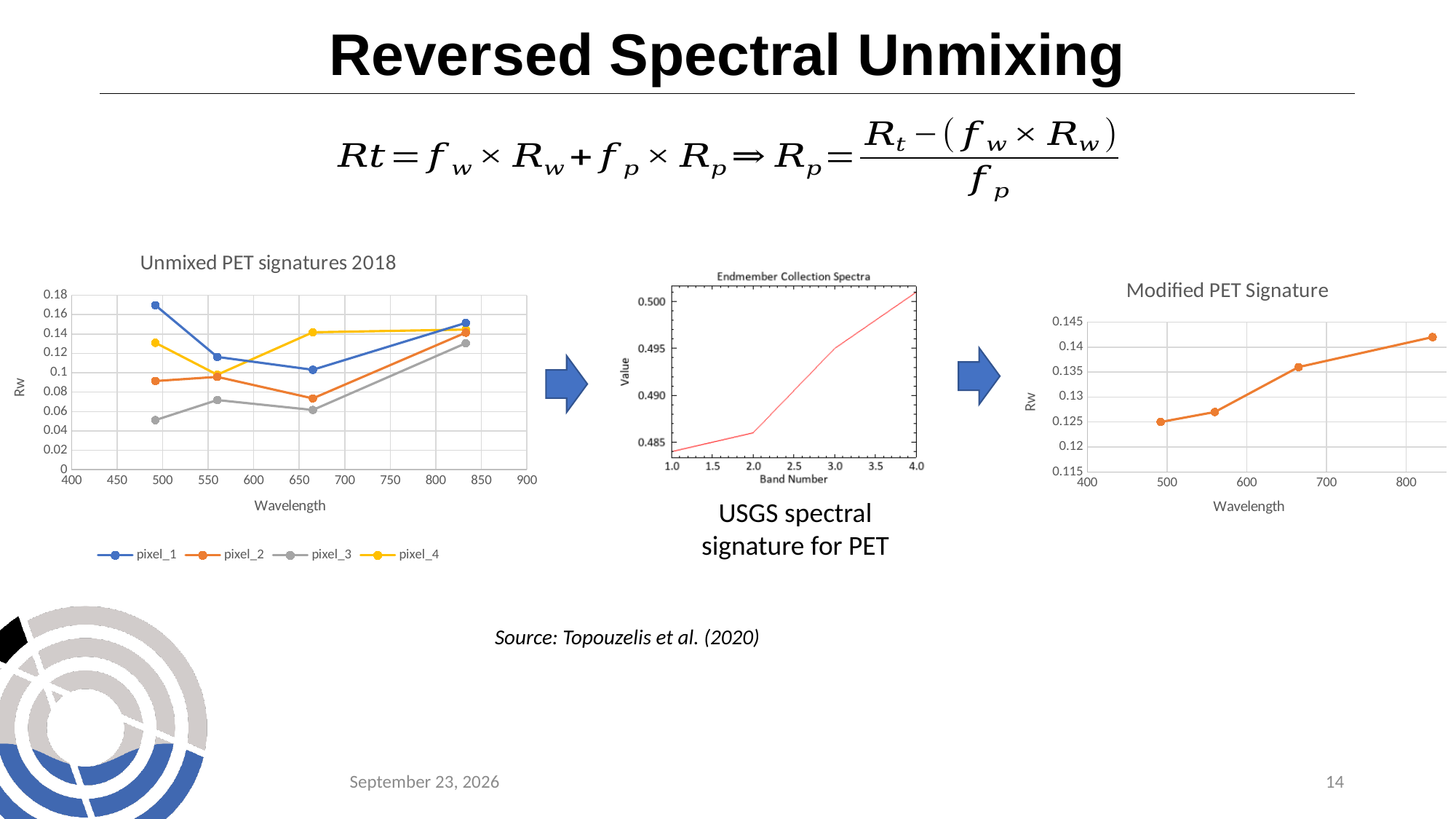
In the 'Modified PET Signature' chart, is the Rw value at the first point (around 490) greater or less than 0.13? less In 'Unmixed PET signatures 2018', is the Rw value of pixel_3 at its first point greater or less than 0.08? less In 'Unmixed PET signatures 2018', does the pixel_3 series rise or fall between the wavelength points around 665 and 835? rise In 'Unmixed PET signatures 2018', at the wavelength point around 665, which series is higher: pixel_4 or pixel_1? pixel_4 In 'Unmixed PET signatures 2018', which series has the lowest Rw at the first wavelength point (around 490)? pixel_3 In 'Unmixed PET signatures 2018', how many data points does the pixel_1 series have? 4 How many series does the legend of 'Unmixed PET signatures 2018' list? 4 What is the label of the x axis in 'Unmixed PET signatures 2018'? Wavelength In 'Unmixed PET signatures 2018', which series has the highest Rw at the first wavelength point (around 490)? pixel_1 What type of chart is 'Unmixed PET signatures 2018'? line chart In the 'Endmember Collection Spectra' chart, is the value at band number 3.0 greater or less than 0.490? greater In the 'Modified PET Signature' chart, does Rw rise or fall as wavelength increases? rise